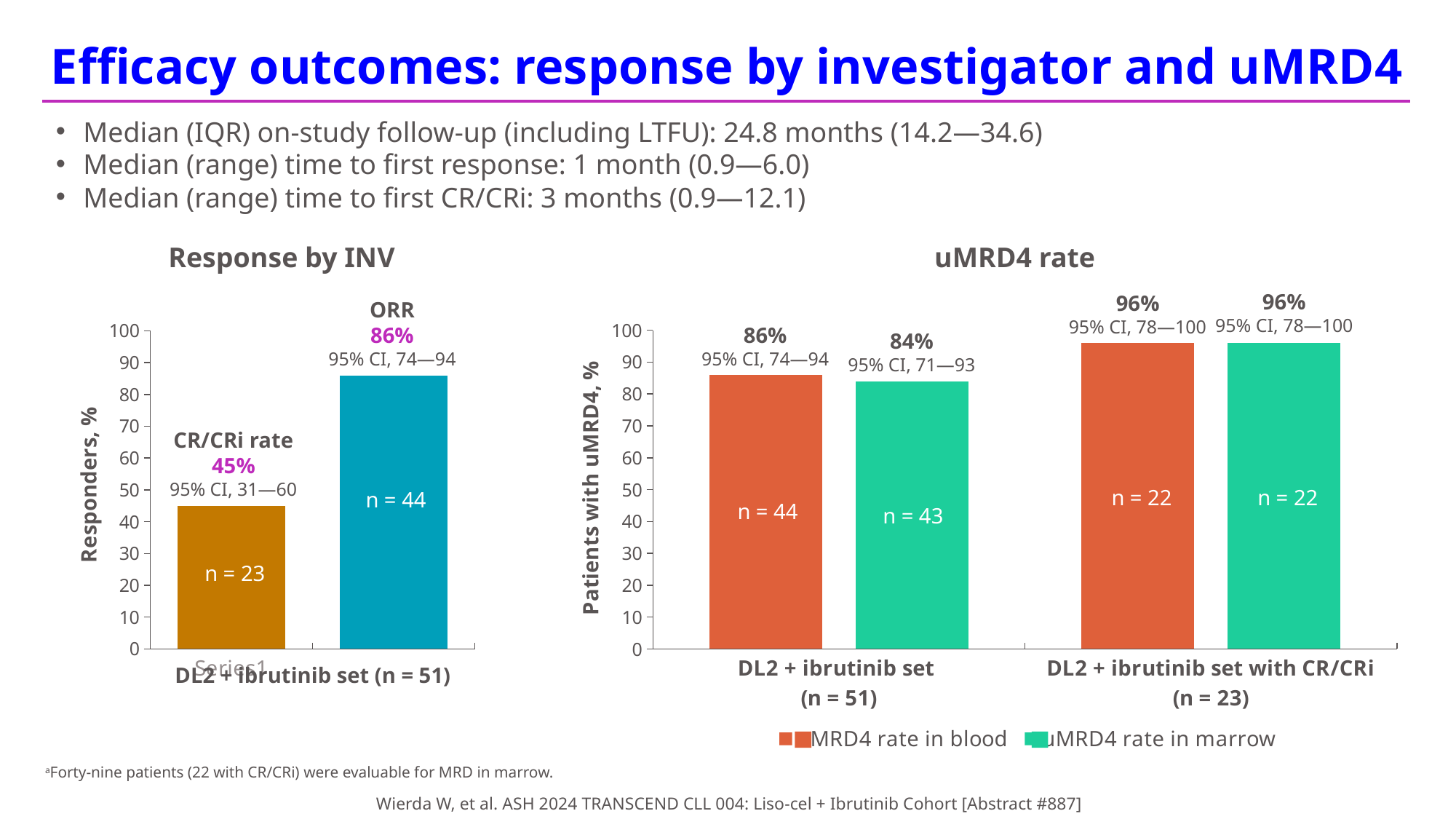
In the 'Response by INV' chart, what is the CR/CRi rate? 45% In the 'Response by INV' chart, what is the ORR value? 86% In the 'uMRD4 rate' chart, what is the uMRD4 rate in blood for the DL2 + ibrutinib set (n = 51)? 86% In the 'Response by INV' chart, what is the difference between the ORR and the CR/CRi rate? 41% In the 'uMRD4 rate' chart, what is the uMRD4 rate in blood for the DL2 + ibrutinib set with CR/CRi (n = 23)? 96% In the 'Response by INV' chart, how many patients (n) does the CR/CRi bar represent? n = 23 In the 'uMRD4 rate' chart, which group has the higher uMRD4 rate in marrow: the DL2 + ibrutinib set (n = 51) or the DL2 + ibrutinib set with CR/CRi (n = 23)? DL2 + ibrutinib set with CR/CRi (n = 23) In the 'uMRD4 rate' chart, what is the difference between the blood and marrow uMRD4 rates for the DL2 + ibrutinib set (n = 51)? 2% In the 'uMRD4 rate' chart, what is the uMRD4 rate in marrow for the DL2 + ibrutinib set (n = 51)? 84% In the 'uMRD4 rate' chart, how many series does the legend list? 2 In the 'uMRD4 rate' chart, what is the label of the y axis? Patients with uMRD4, % What type of chart is the 'uMRD4 rate' chart? Bar chart